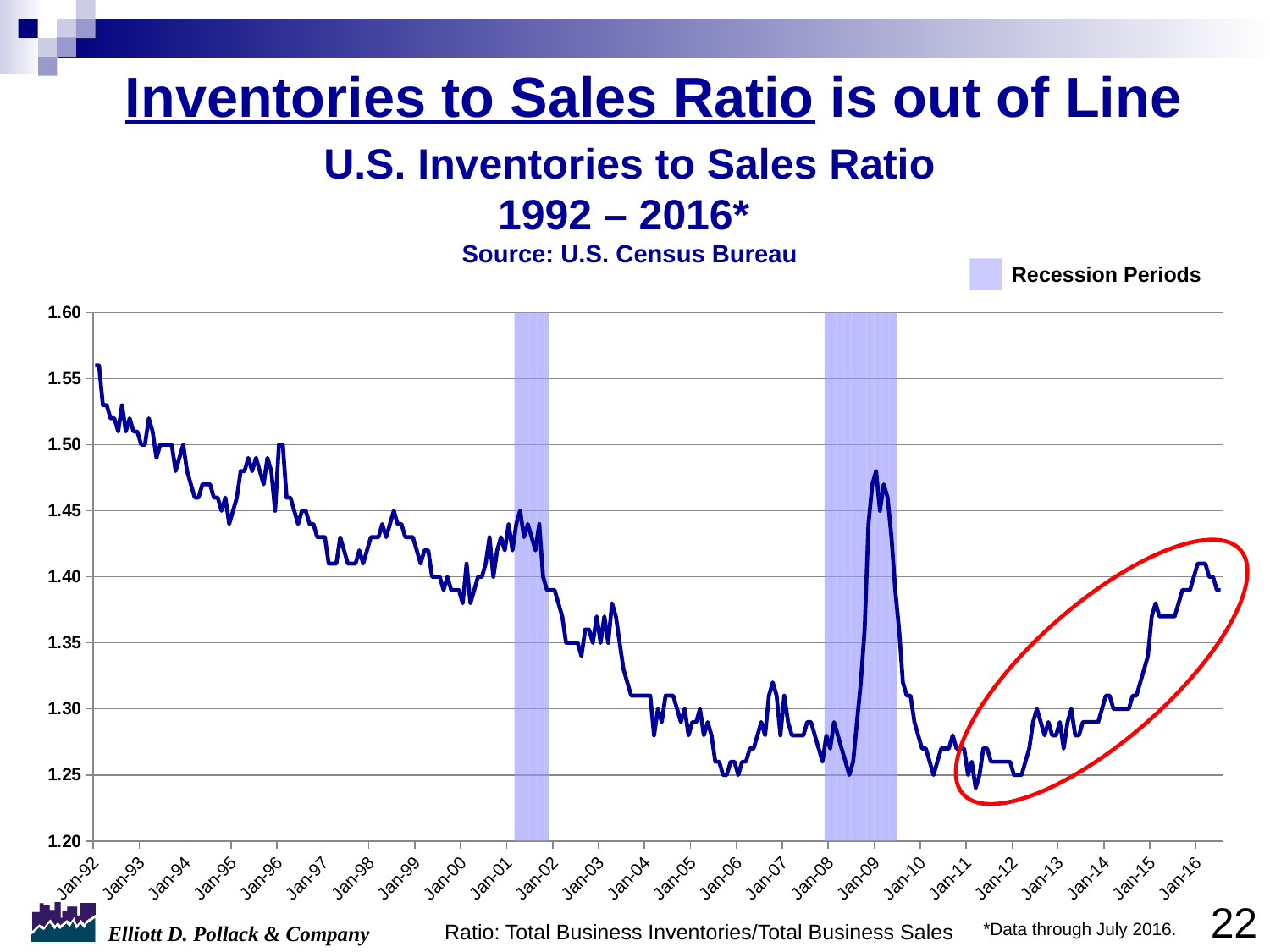
What does the shaded legend entry on the chart represent? Recession Periods How many recession periods are shaded on the chart? 2 Does the ratio generally rise or fall from Jan-11 to Jan-16? rise What kind of chart is shown on the slide? line chart What is the title of the chart on the slide? U.S. Inventories to Sales Ratio 1992 – 2016* Which is larger, the value at Jan-92 or the value at Jan-16? Jan-92 Is the value for Jan-98 greater or less than 1.45? less Is the value for Jan-92 greater or less than 1.50? greater Does the ratio generally rise or fall from Jan-92 to Jan-06? fall Is the value for Jan-11 greater or less than 1.30? less